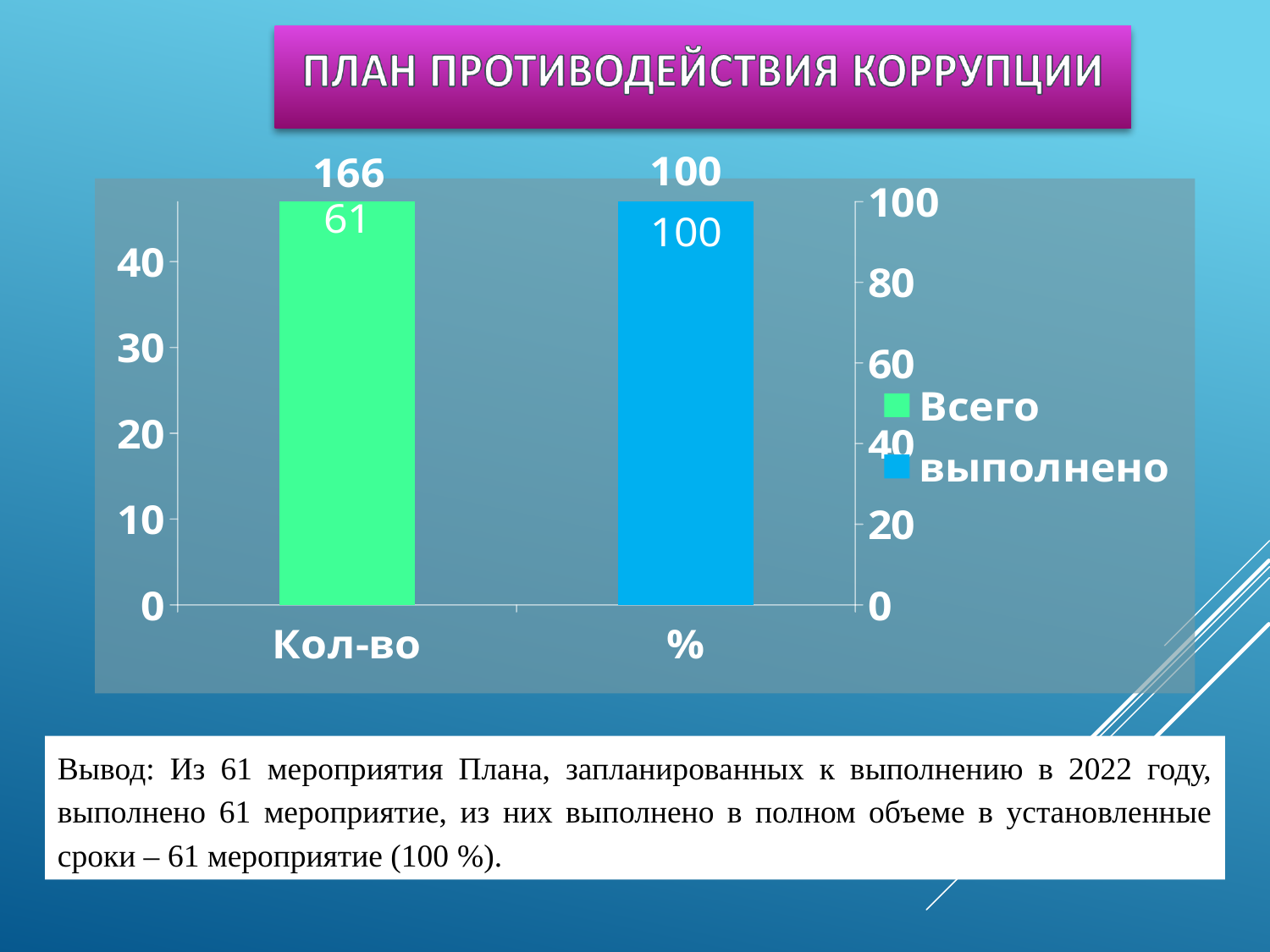
What is the highest tick value shown on the right-hand axis of the chart? 100 What are the two entries in the chart legend? Всего, выполнено What is the data label on the blue bar for the category "%"? 100 Is the value of the green "Кол-во" bar, read on the left axis, greater or less than 40? greater What kind of chart is shown on the slide? bar chart How many series does the chart legend list? 2 Which colour is used for the "выполнено" series in the legend? blue How many bars (categories) are plotted on the chart? 2